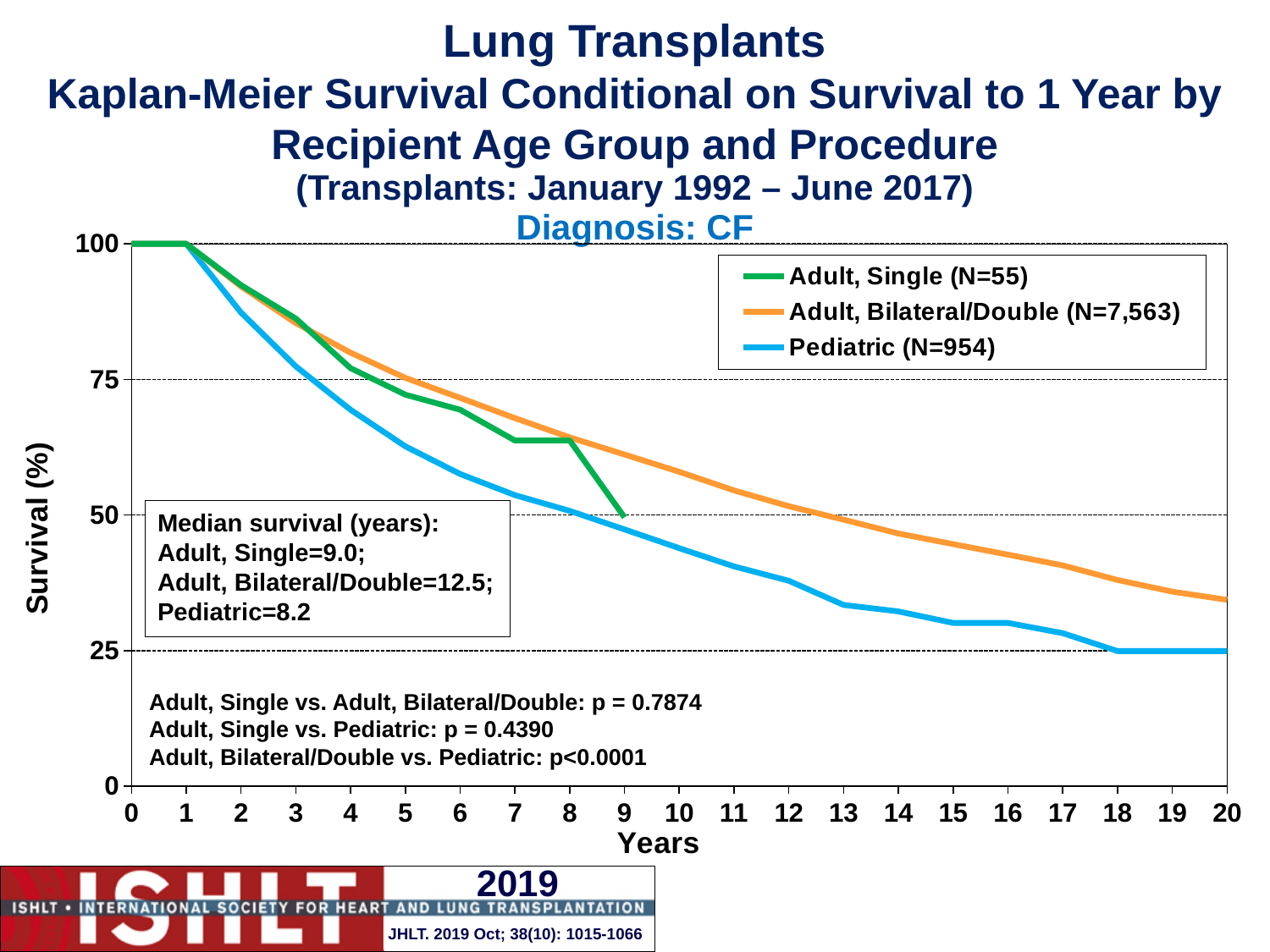
What kind of chart is shown on the slide? line chart What is the median survival in years for the Adult, Single group? 9.0 What is the difference in median survival (years) between the Adult, Bilateral/Double group and the Pediatric group? 4.3 Is the survival value for the Pediatric group at 10 years greater or less than 50? less How many series does the legend list? 3 What is the N for the Adult, Bilateral/Double group shown in the legend? 7,563 What is the median survival in years for the Pediatric group? 8.2 Do the survival curves rise or fall as years increase? fall Which group has the lowest median survival? Pediatric What is the median survival in years for the Adult, Bilateral/Double group? 12.5 At 10 years, which group has higher survival: Adult, Bilateral/Double or Pediatric? Adult, Bilateral/Double Which group has the highest median survival? Adult, Bilateral/Double